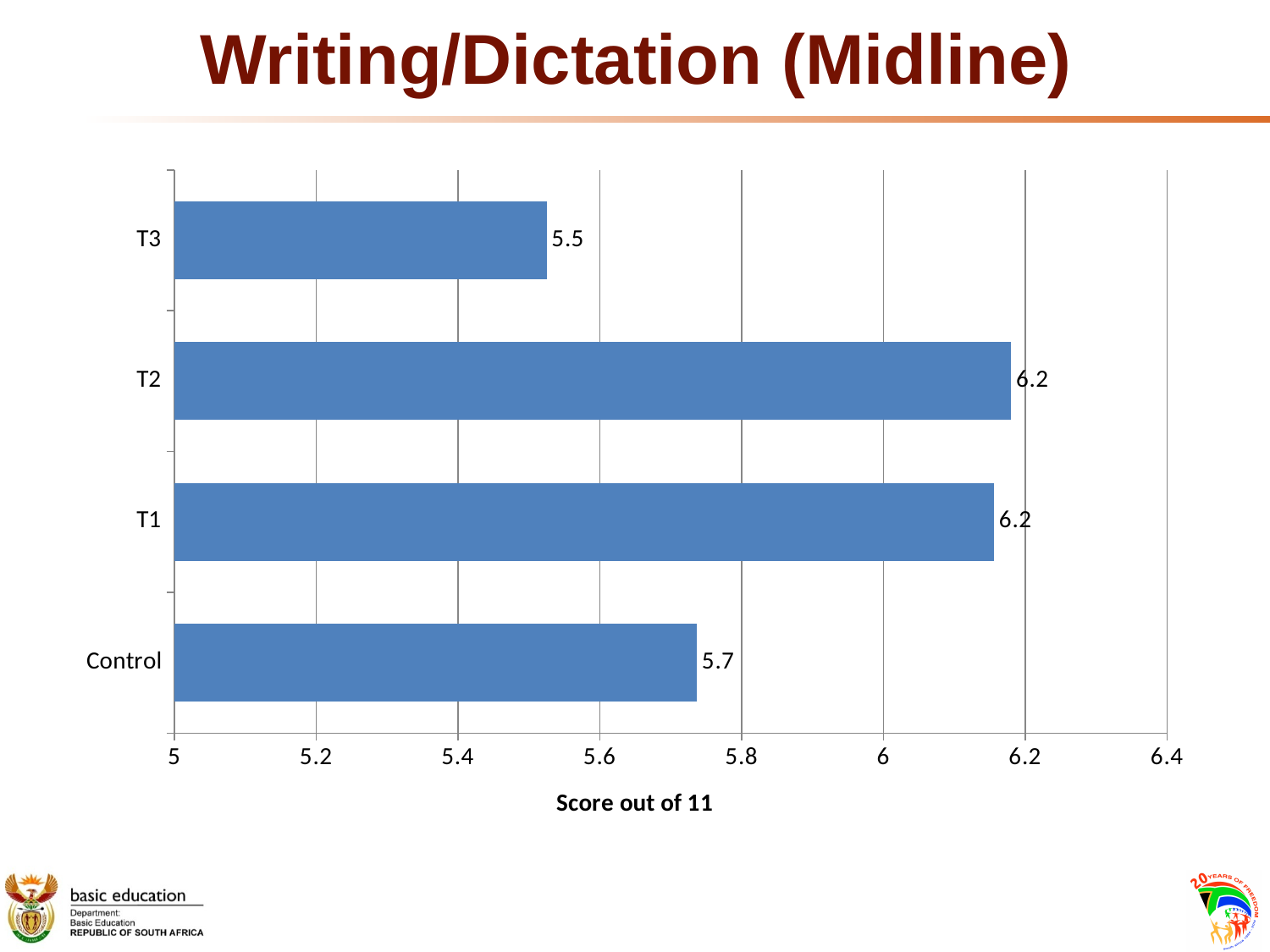
What is the value for T2? 6.2 What is the value for Control? 5.7 What kind of chart is shown on the slide? Bar chart What is the label of the horizontal axis? Score out of 11 What is the value for T3? 5.5 How many categories are shown in the chart? 4 What is the difference between the values for Control and T3? 0.2 What is the value for T1? 6.2 Which is larger, the value for Control or the value for T3? Control What is the difference between the values for T2 and Control? 0.5 Is the value for T1 greater or less than 6? greater Which category has the lowest value? T3